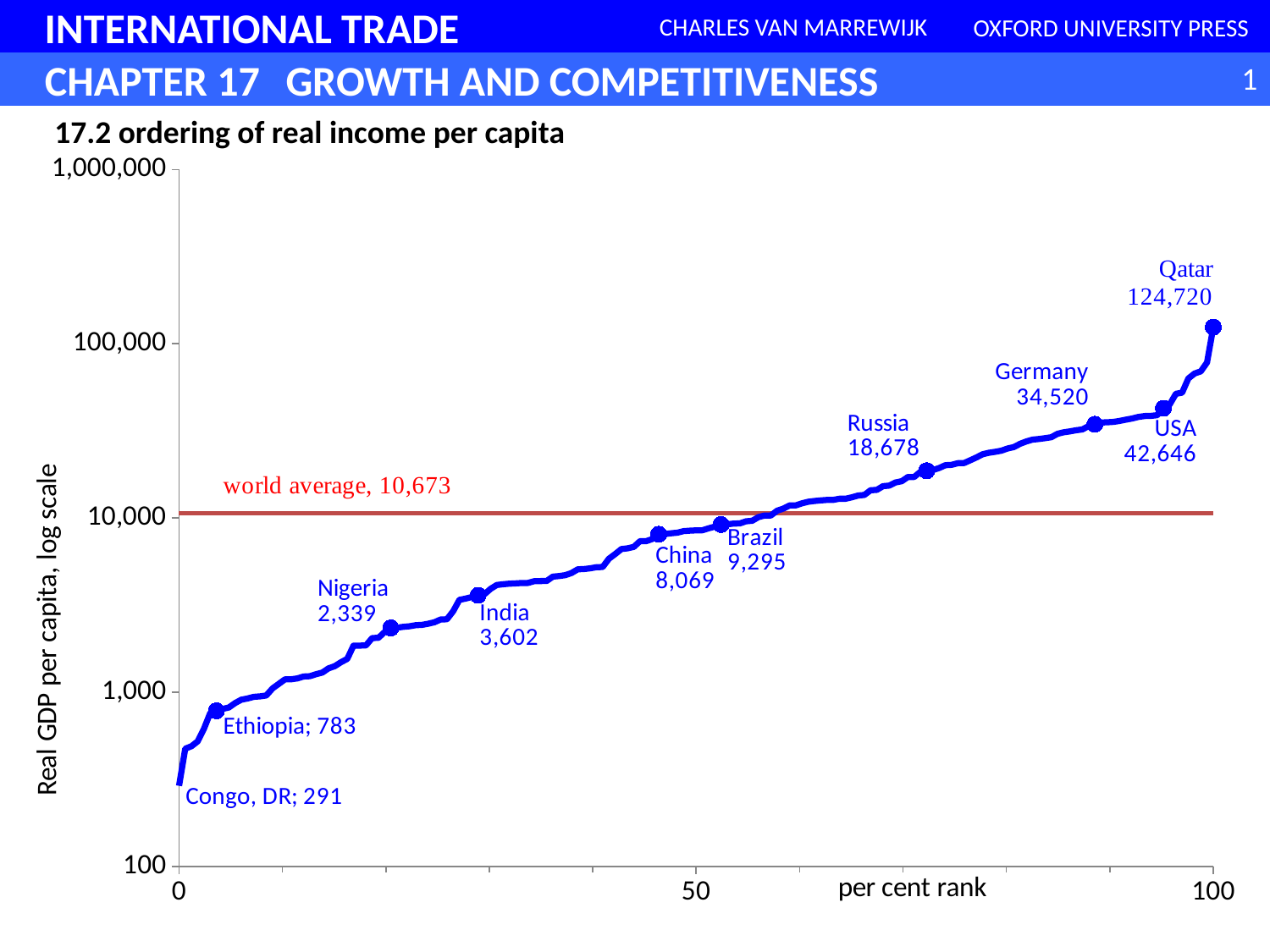
What is the title of the chart? 17.2 ordering of real income per capita What is the real GDP per capita shown for Brazil? 9,295 Is the value for Russia greater or less than 10,000? greater Which has a higher real GDP per capita, China or India? China Which labelled country has the highest real GDP per capita? Qatar What is the difference between the real GDP per capita of the USA and Germany? 8,126 What is the real GDP per capita shown for Qatar? 124,720 Do the values rise or fall as the per cent rank increases along the x axis? rise Which labelled country has the lowest real GDP per capita? Congo, DR What kind of chart is shown on the slide? line chart What value is given for the world average? 10,673 What is the real GDP per capita shown for Ethiopia? 783